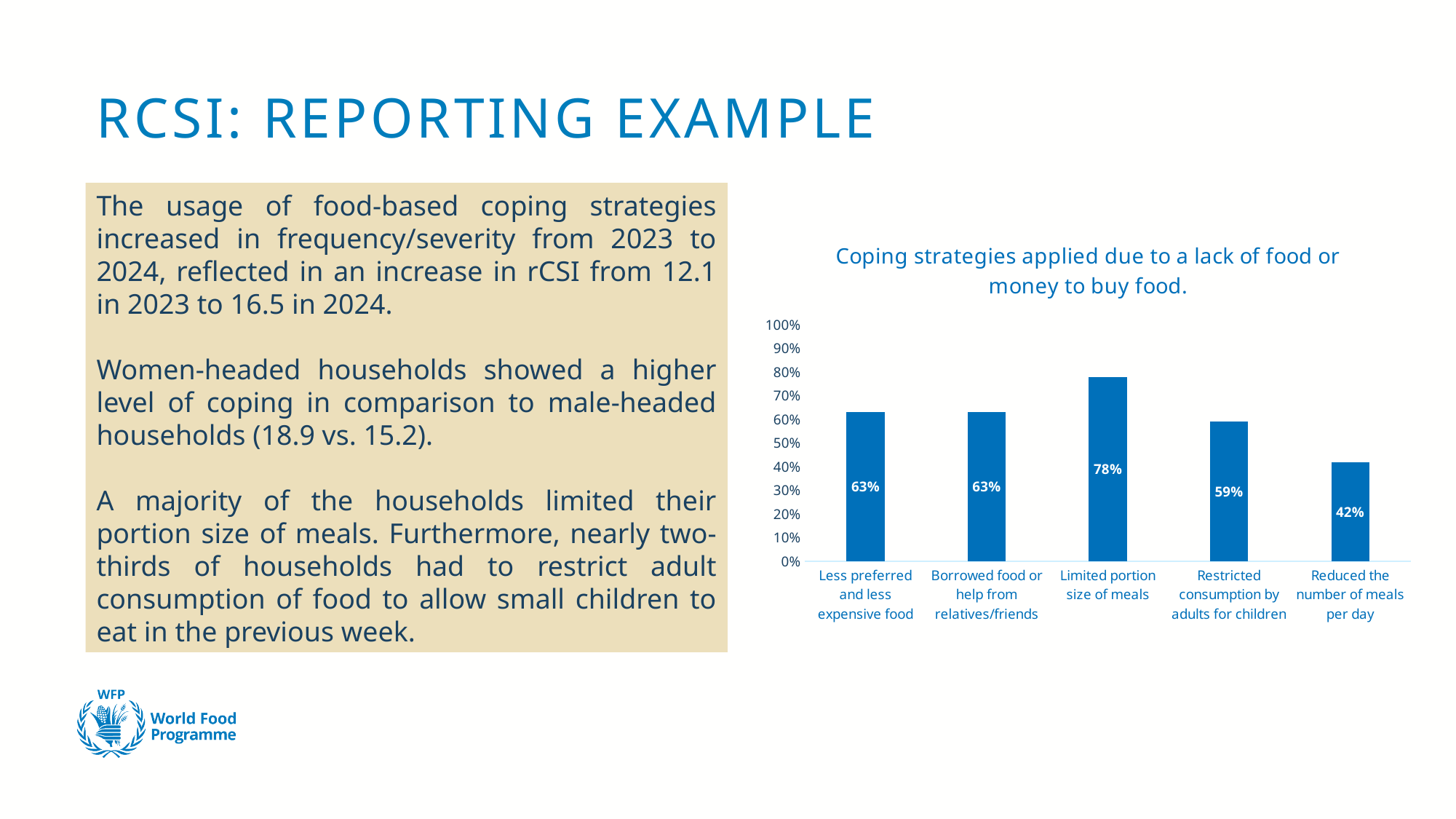
Which coping strategy has the highest value? Limited portion size of meals Is the value for 'Reduced the number of meals per day' greater or less than 50%? less What is the value for 'Restricted consumption by adults for children'? 59% What is the difference between the values for 'Limited portion size of meals' and 'Reduced the number of meals per day'? 36% Which coping strategy has the lowest value? Reduced the number of meals per day What type of chart is shown on the slide? Bar chart What is the difference between 'Less preferred and less expensive food' and 'Restricted consumption by adults for children'? 4% How many coping strategies are shown in the chart? 5 Which is larger: the value for 'Borrowed food or help from relatives/friends' or 'Restricted consumption by adults for children'? Borrowed food or help from relatives/friends What percentage of households limited portion size of meals? 78% What is the value for 'Reduced the number of meals per day'? 42% What is the title of the chart? Coping strategies applied due to a lack of food or money to buy food.